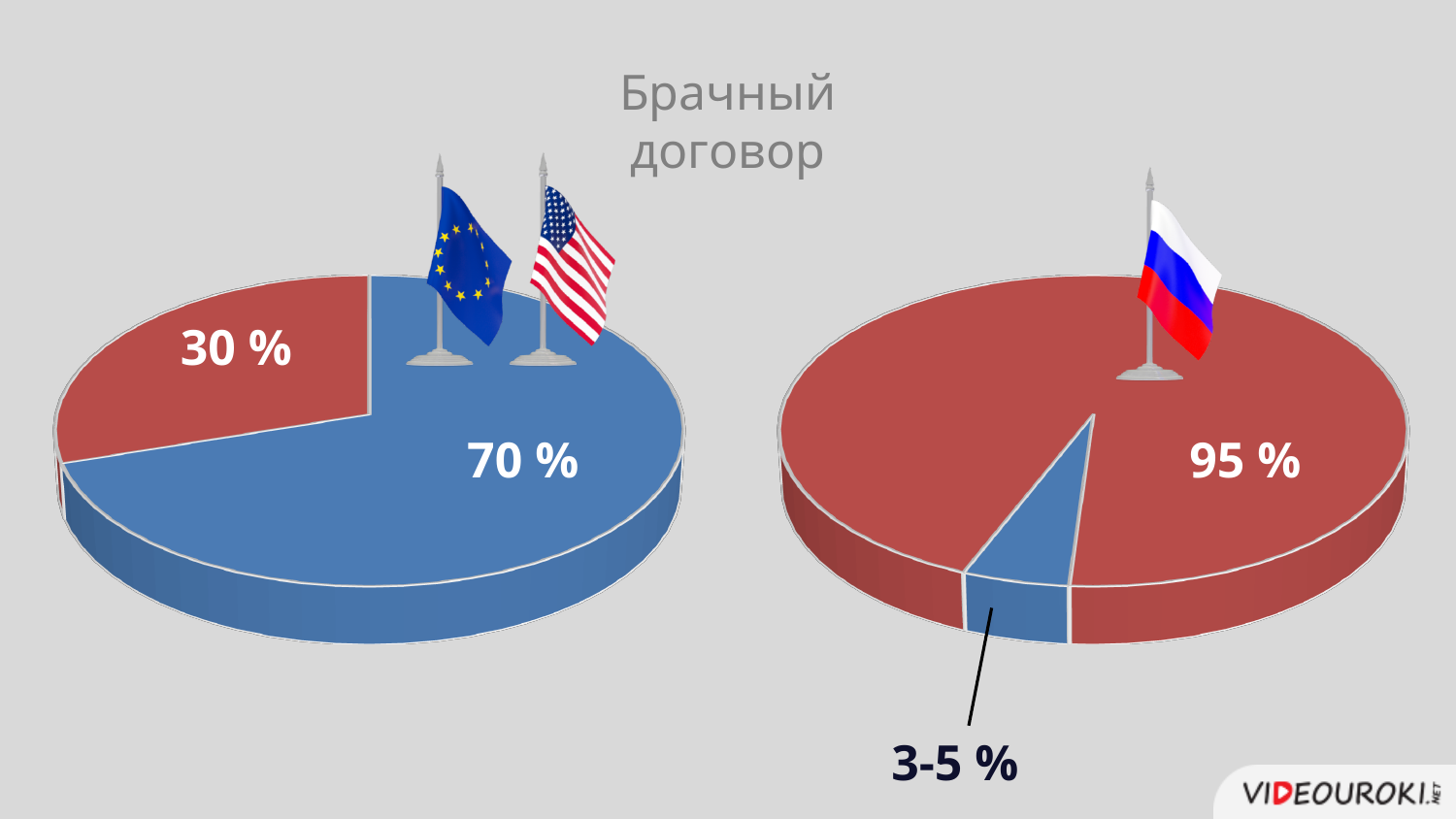
In the left pie chart (with the EU and US flags), what value is shown for the red slice? 30 % In the right pie chart (with the Russian flag), which slice is the largest? The red slice (95 %) How many slices does the left pie chart (with the EU and US flags) have? 2 How many charts are on the slide? 2 In the left pie chart (with the EU and US flags), which slice is larger, the blue one or the red one? Blue What kind of charts are shown on the slide? Pie charts Which chart shows the larger red slice, the left one (EU/US flags) or the right one (Russian flag)? The right one (Russian flag) What is the title shown at the top of the slide? Брачный договор In the right pie chart (with the Russian flag), what value is shown for the red slice? 95 % In the left pie chart (with the EU and US flags), what is the difference between the blue slice and the red slice? 40 % In the left pie chart (with the EU and US flags), what value is shown for the blue slice? 70 % In the right pie chart (with the Russian flag), what value is shown for the small blue slice? 3-5 %